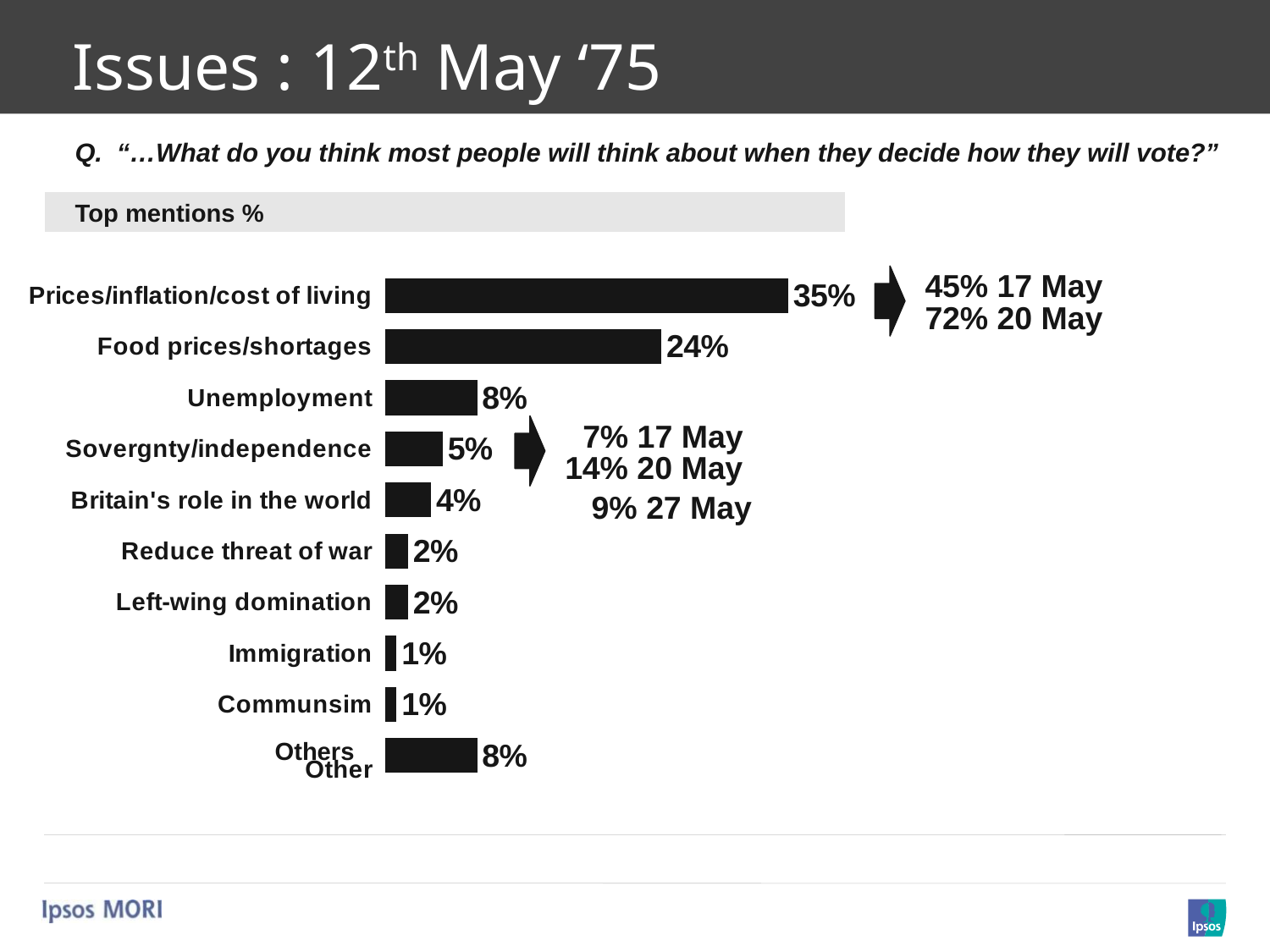
What is the difference between the values for Prices/inflation/cost of living and Food prices/shortages? 11% Which category has the highest value in the chart? Prices/inflation/cost of living What value is shown for Immigration? 1% How many categories are plotted in the chart? 10 What is the label of the grey header box above the chart? Top mentions % Which is larger, the value for Sovergnty/independence or the value for Britain's role in the world? Sovergnty/independence What percentage is shown for Britain's role in the world? 4% What percentage is shown for Prices/inflation/cost of living? 35% What kind of chart is shown on the slide? Bar chart What is the difference between the values for Unemployment and Sovergnty/independence? 3% What percentage is shown for Unemployment? 8% What percentage is shown for Food prices/shortages? 24%